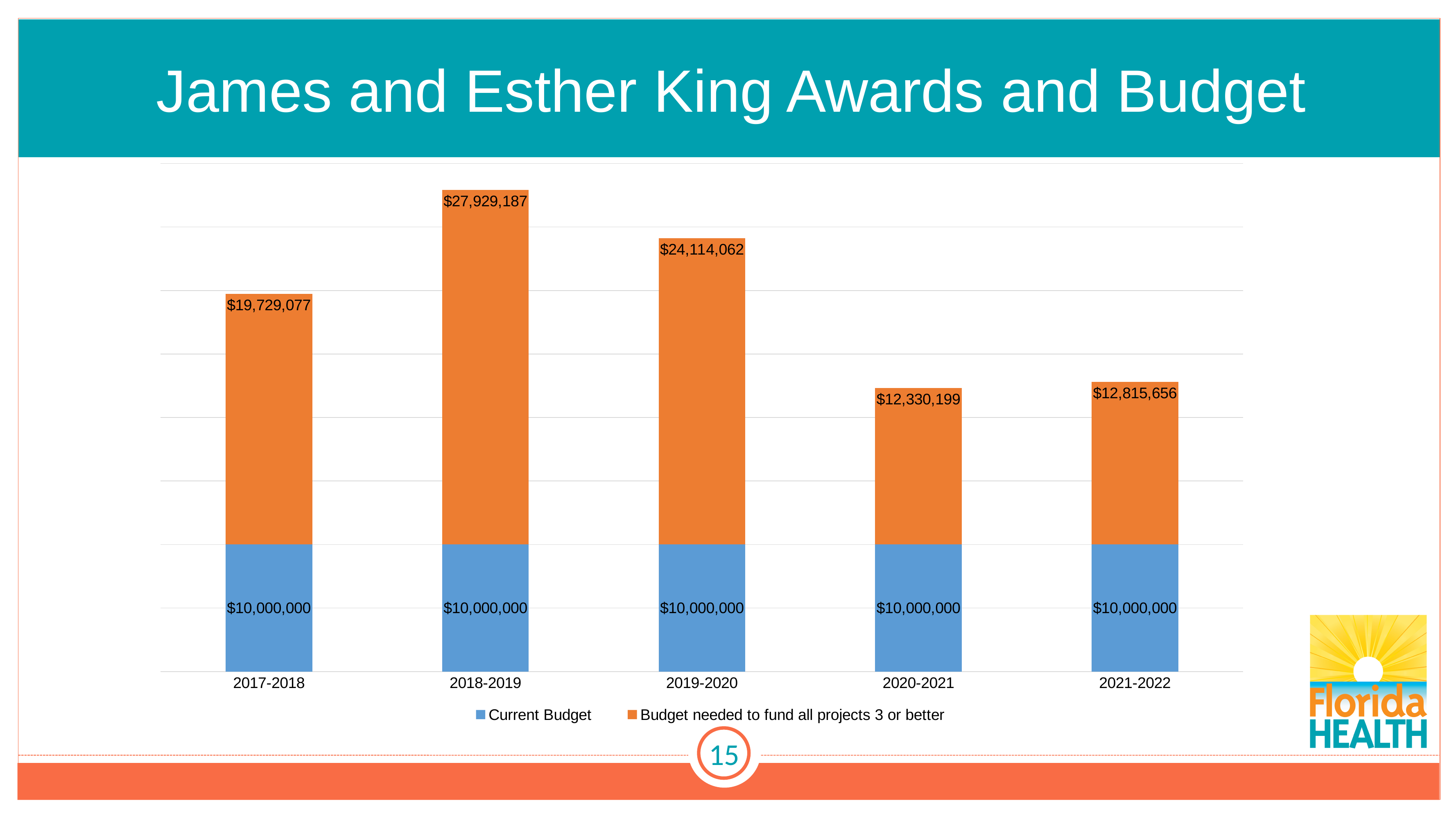
What is the 'Current Budget' value for 2020-2021? $10,000,000 What is the difference between the 'Budget needed to fund all projects 3 or better' for 2018-2019 and 2019-2020? $3,815,125 What is the value of 'Budget needed to fund all projects 3 or better' for 2018-2019? $27,929,187 Which year has the lowest 'Budget needed to fund all projects 3 or better'? 2020-2021 How many series does the legend list? 2 Which year has the highest 'Budget needed to fund all projects 3 or better'? 2018-2019 Which colour represents 'Current Budget' in the chart? Blue How many years are shown on the x axis? 5 What is the value of 'Budget needed to fund all projects 3 or better' for 2021-2022? $12,815,656 Is the 'Budget needed to fund all projects 3 or better' larger for 2017-2018 or for 2019-2020? 2019-2020 What kind of chart is shown on the slide? Stacked bar chart What is the total height of the stacked bar for 2020-2021? $22,330,199